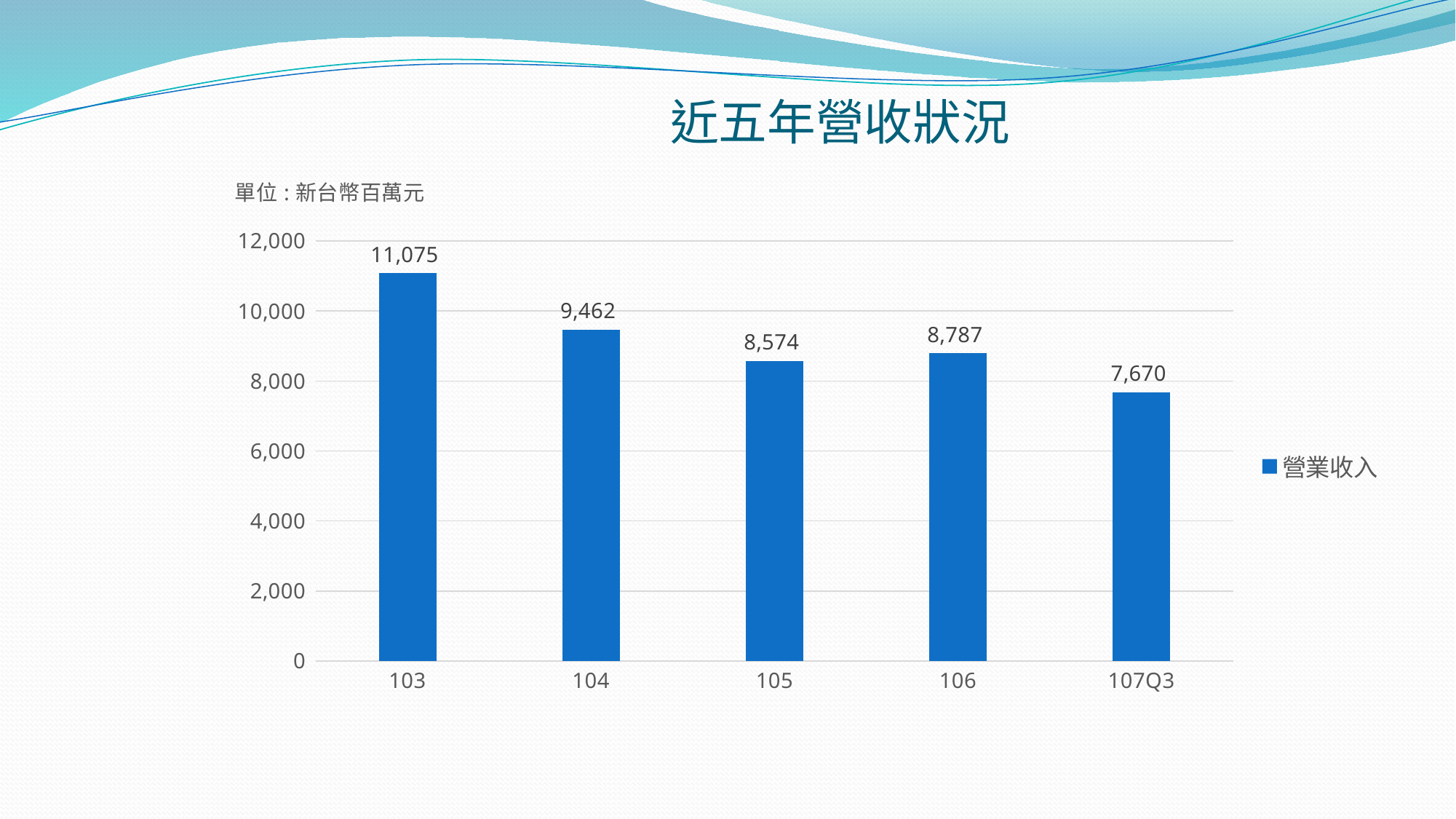
What is the 營業收入 value for 103? 11,075 What kind of chart is shown on the slide? bar chart What unit is stated for the chart values? 新台幣百萬元 What is the 營業收入 value for 105? 8,574 Is the value for 107Q3 greater or less than 8,000? less Which category has the lowest 營業收入? 107Q3 How many categories are shown on the x axis? 5 What is the difference in 營業收入 between 103 and 104? 1,613 What is the 營業收入 value for 107Q3? 7,670 Which has a larger 營業收入, 104 or 106? 104 Which category has the highest 營業收入? 103 What is the difference in 營業收入 between 106 and 105? 213